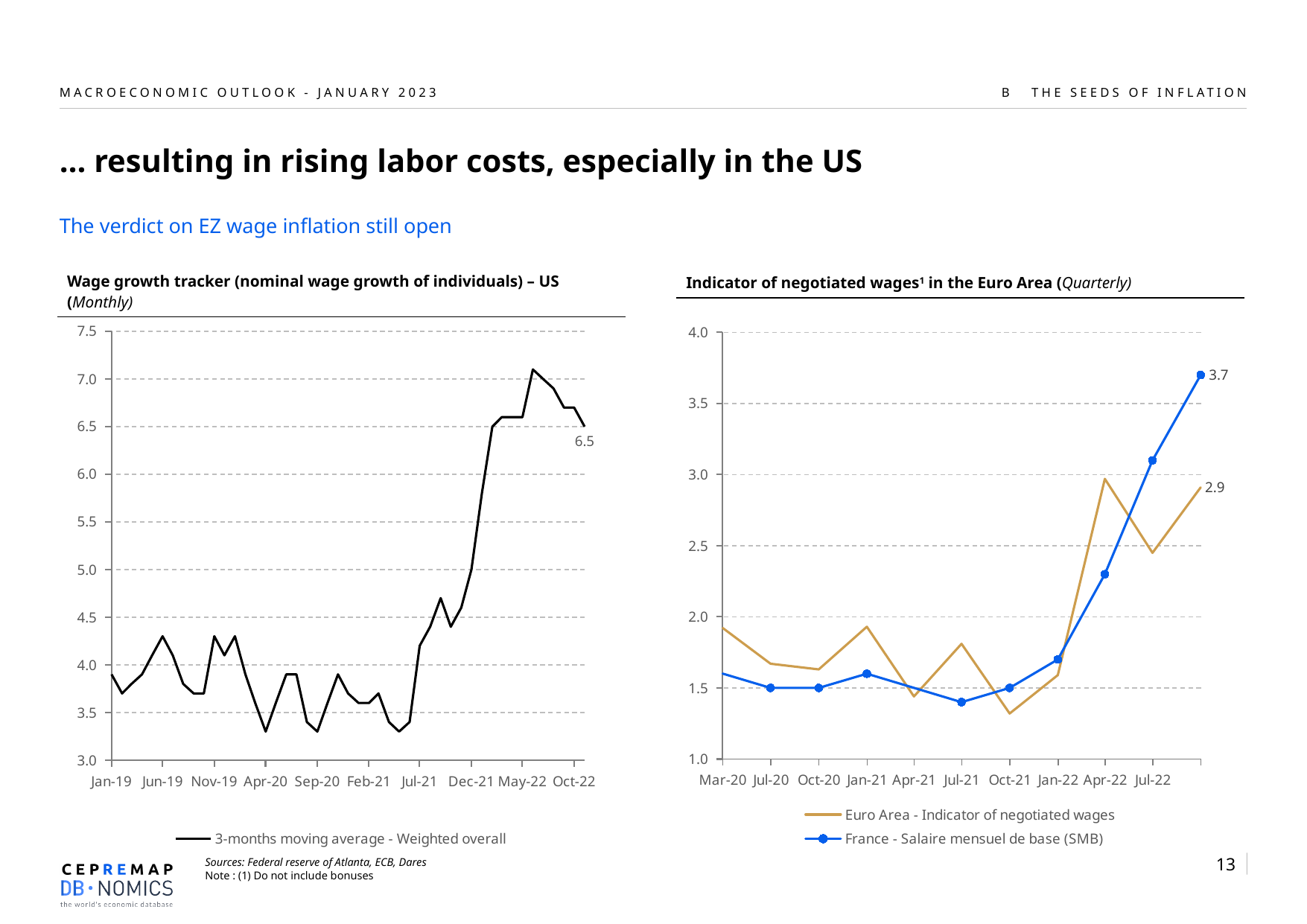
How many series does the legend of the 'Wage growth tracker' chart on the left list? 1 In the 'Wage growth tracker' chart on the left, is the value at Jul-21 greater or less than 4.0? greater In the 'Indicator of negotiated wages in the Euro Area' chart on the right, what is the labelled final value of the France - Salaire mensuel de base (SMB) series? 3.7 What is the legend entry of the 'Wage growth tracker' chart on the left? 3-months moving average - Weighted overall What type of chart is the 'Wage growth tracker' chart on the left? line chart In the 'Indicator of negotiated wages in the Euro Area' chart on the right, is the Euro Area value at Oct-21 greater or less than 1.5? less How many series does the legend of the 'Indicator of negotiated wages in the Euro Area' chart on the right list? 2 In the 'Wage growth tracker' chart on the left, what is the labelled value at the end of the series (Oct-22)? 6.5 In the 'Wage growth tracker' chart on the left, does the series overall rise or fall between Jan-19 and the end of the series? rise In the 'Indicator of negotiated wages in the Euro Area' chart on the right, what is the labelled final value of the Euro Area - Indicator of negotiated wages series? 2.9 In the 'Wage growth tracker' chart on the left, is the value at Oct-22 greater or less than 6.0? greater In the 'Indicator of negotiated wages in the Euro Area' chart on the right, what is the difference between the labelled final values of the France series and the Euro Area series? 0.8